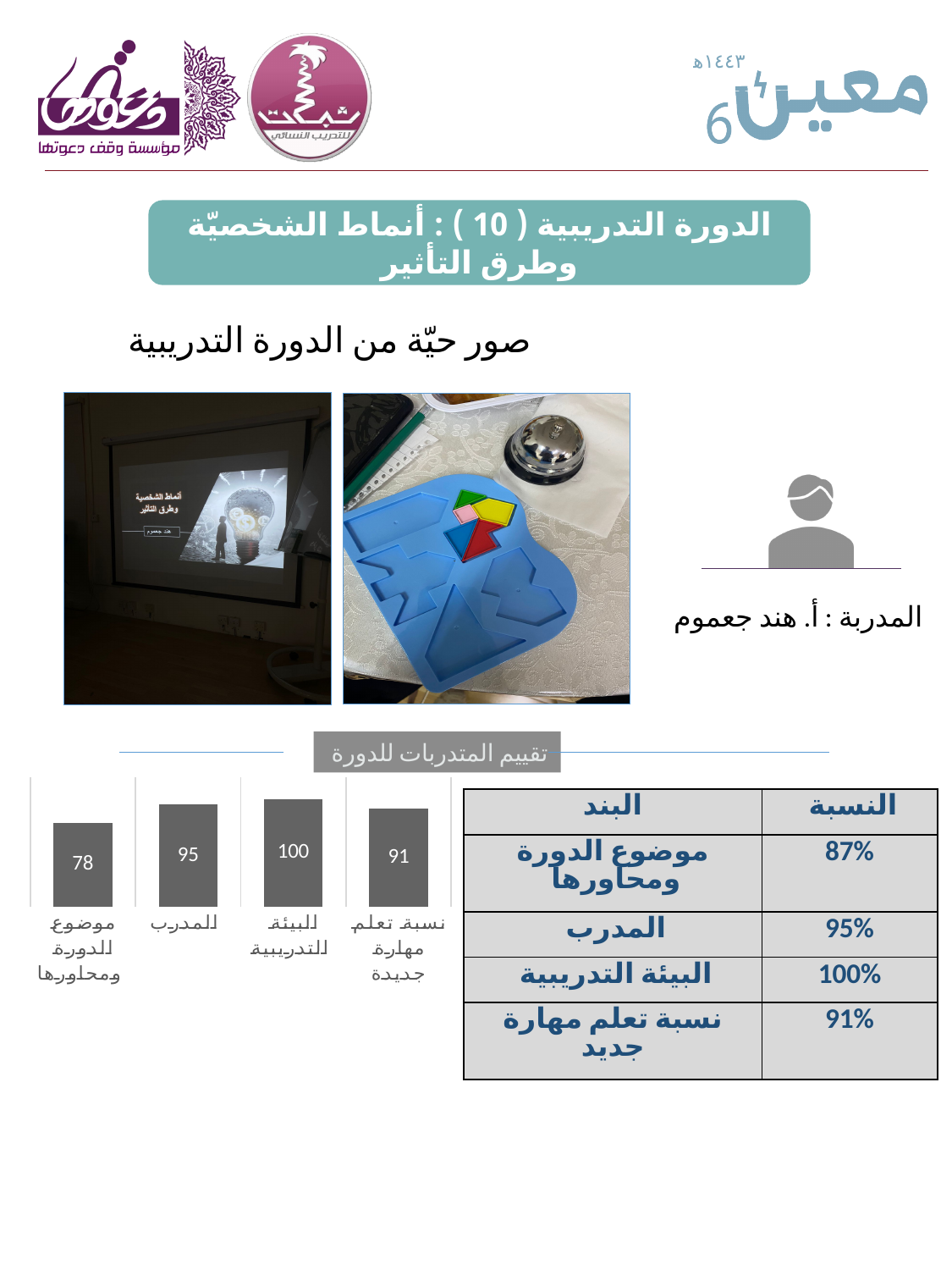
What is the difference between the bar values for البيئة التدريبية and موضوع الدورة ومحاورها? 22 What value does the bar chart show for نسبة تعلم مهارة جديدة? 91 What is the title shown above the chart? تقييم المتدربات للدورة Which category has the lowest bar in the chart? موضوع الدورة ومحاورها What is the difference between the bar values for المدرب and نسبة تعلم مهارة جديدة? 4 What value does the bar chart show for المدرب? 95 What type of chart is shown on the slide? bar chart Which category has the highest bar in the chart? البيئة التدريبية Which is larger in the bar chart, the value for المدرب or the value for نسبة تعلم مهارة جديدة? المدرب What value does the bar chart show for موضوع الدورة ومحاورها? 78 What value does the bar chart show for البيئة التدريبية? 100 How many bars are shown in the chart? 4